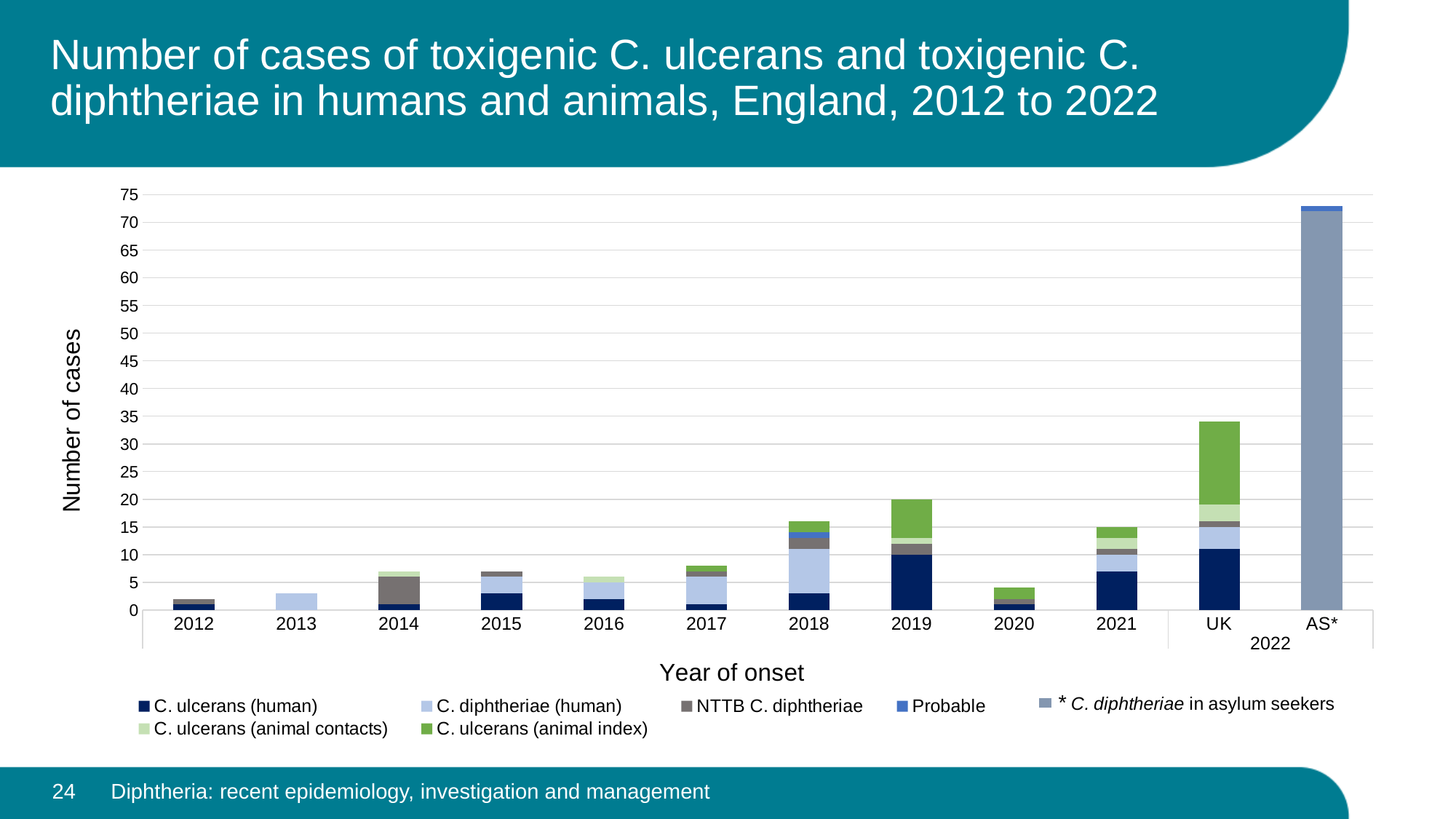
Which bar is taller, 2019 or 2018? 2019 Which category has the tallest bar? AS* (2022) How many bars (categories) are plotted along the x axis? 12 Which bar is taller, 2014 or 2013? 2014 What kind of chart is shown on the slide? stacked bar chart Is the total for AS* 2022 greater or less than 70? greater Which category has the shortest bar? 2012 Is the total for 2019 greater or less than 25? less Is the total for 2020 greater or less than 10? less What is the label of the y axis? Number of cases How many series does the legend list? 7